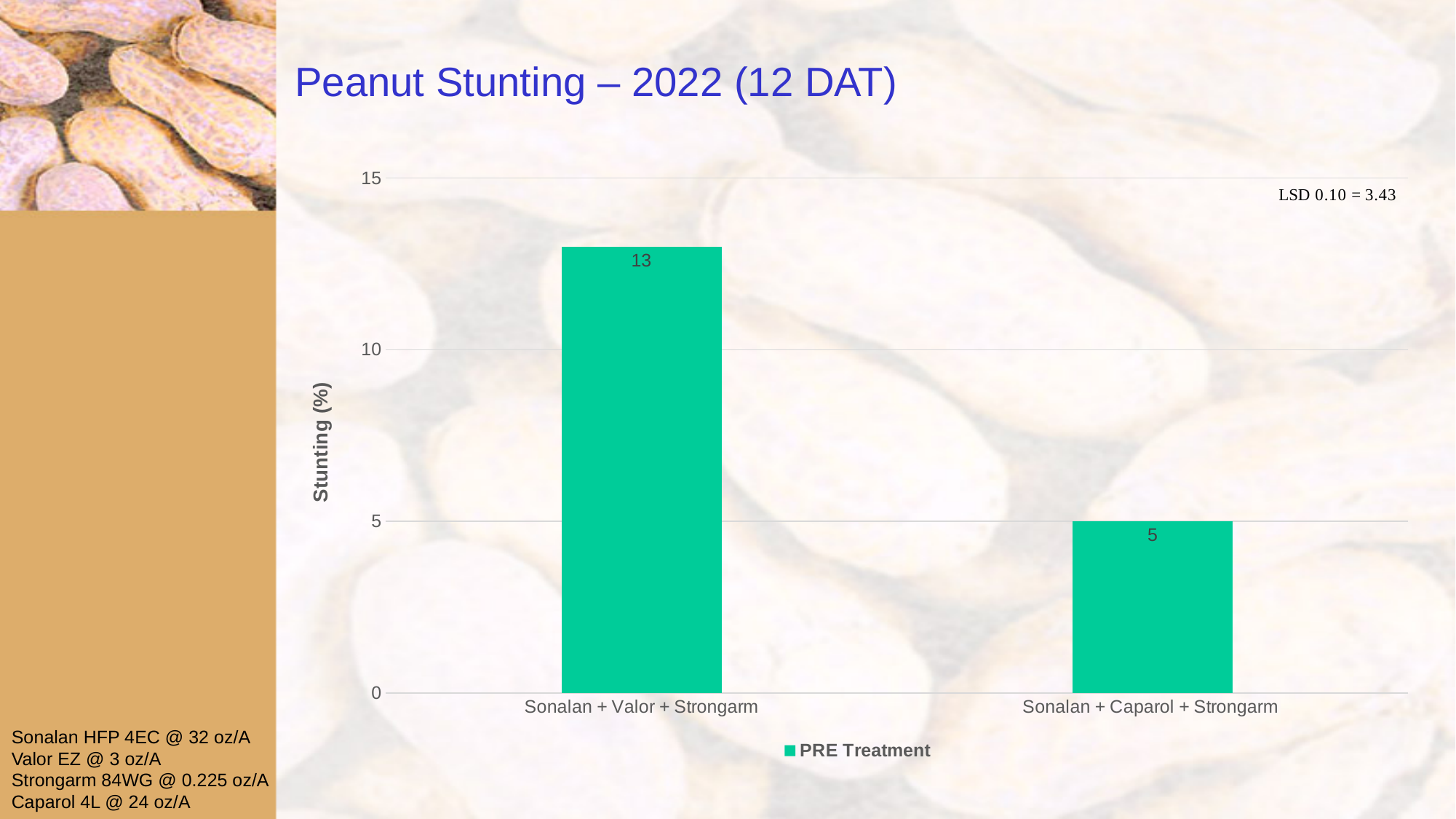
What is the stunting value for Sonalan + Caparol + Strongarm? 5 Which has a larger stunting value, Sonalan + Valor + Strongarm or Sonalan + Caparol + Strongarm? Sonalan + Valor + Strongarm What is the label of the y axis? Stunting (%) Which treatment has the lowest stunting value? Sonalan + Caparol + Strongarm Which treatment has the highest stunting value? Sonalan + Valor + Strongarm Is the stunting value for Sonalan + Valor + Strongarm greater or less than 10? greater How many treatments are shown on the chart? 2 What is the title of the chart? Peanut Stunting – 2022 (12 DAT) What kind of chart is shown on the slide? bar chart What is the stunting value for Sonalan + Valor + Strongarm? 13 How many series does the legend list? 1 What is the difference in stunting between Sonalan + Valor + Strongarm and Sonalan + Caparol + Strongarm? 8